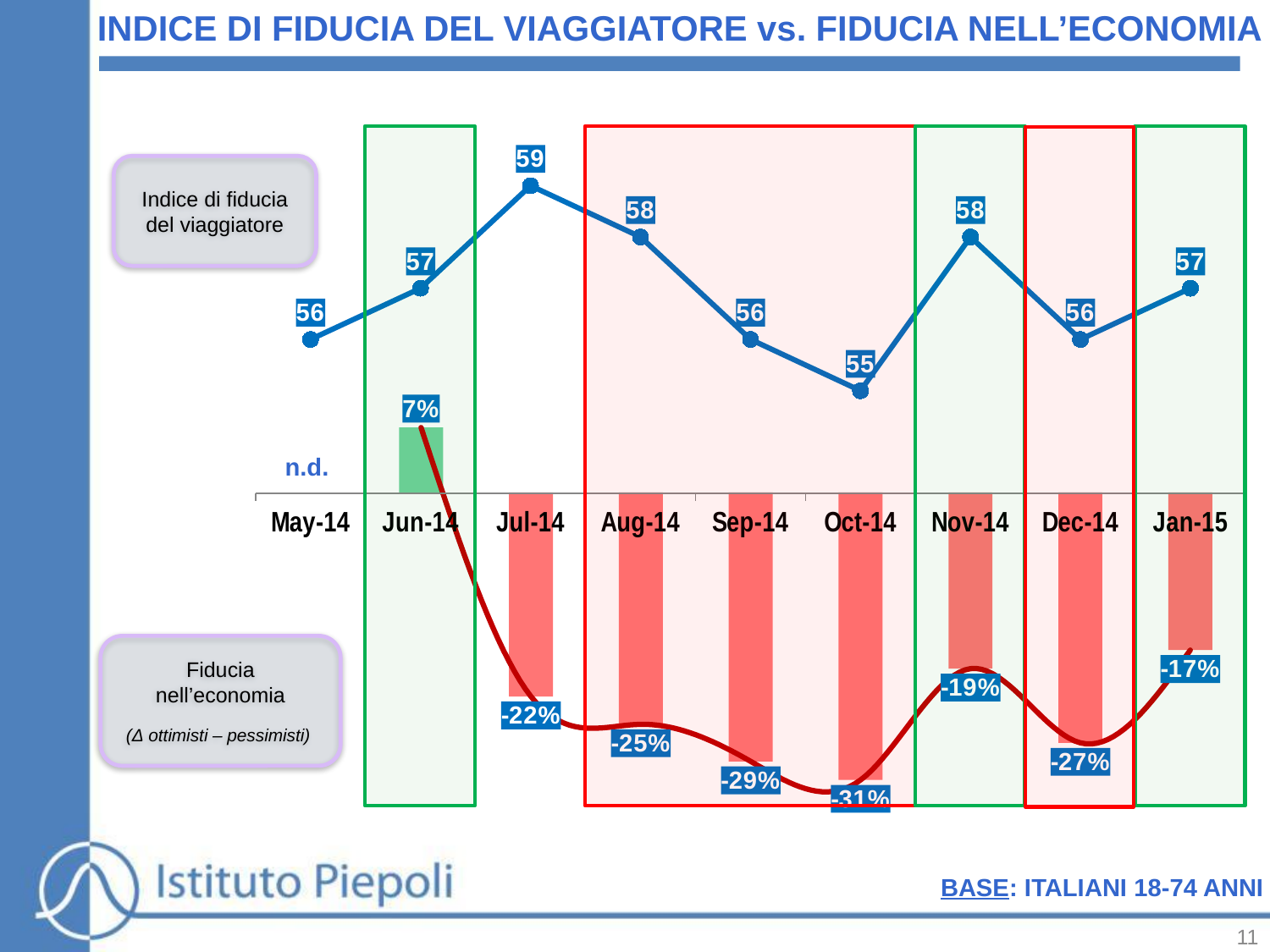
What is the difference between the Indice di fiducia del viaggiatore in Jul-14 and in Oct-14? 4 What is the value of the Indice di fiducia del viaggiatore in Jul-14? 59 What is the Fiducia nell'economia value for Jun-14? 7% In which month is the Indice di fiducia del viaggiatore at its lowest? Oct-14 Which is larger, the Fiducia nell'economia value in Nov-14 or in Dec-14? Nov-14 How many months are shown on the x axis? 9 Which month has the lowest Fiducia nell'economia value? Oct-14 Does the Indice di fiducia del viaggiatore rise or fall from Jul-14 to Oct-14? fall What is the title of the chart on the slide? INDICE DI FIDUCIA DEL VIAGGIATORE vs. FIDUCIA NELL'ECONOMIA In which month does the Indice di fiducia del viaggiatore reach its highest value? Jul-14 What is the Fiducia nell'economia value shown for May-14? n.d. What is the Fiducia nell'economia value for Oct-14? -31%